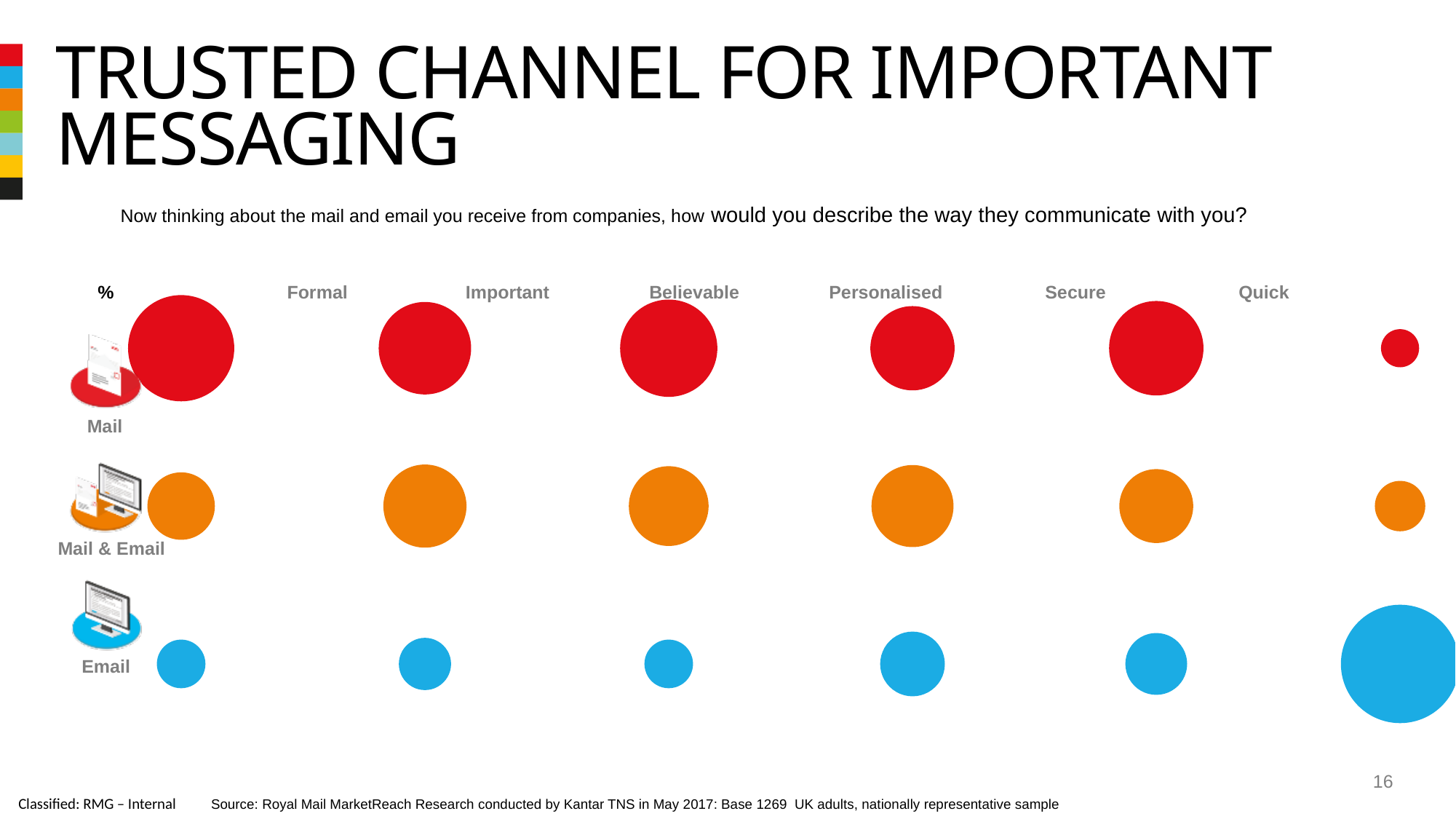
For the Formal attribute, which channel has the largest bubble? Mail How many attribute categories are shown along the top of the chart? 6 In the Mail row, which attribute has the smallest bubble? Quick For the Believable attribute, which is larger: the Mail bubble or the Email bubble? Mail What colour are the bubbles for the Email row? blue In the Email row, which attribute has the largest bubble? Quick For the Quick attribute, which channel has the largest bubble? Email For the Formal attribute, which channel has the smallest bubble? Email What kind of chart is shown on the slide? bubble chart For the Secure attribute, which channel has the smallest bubble? Email How many channel rows (series) does the chart show? 3